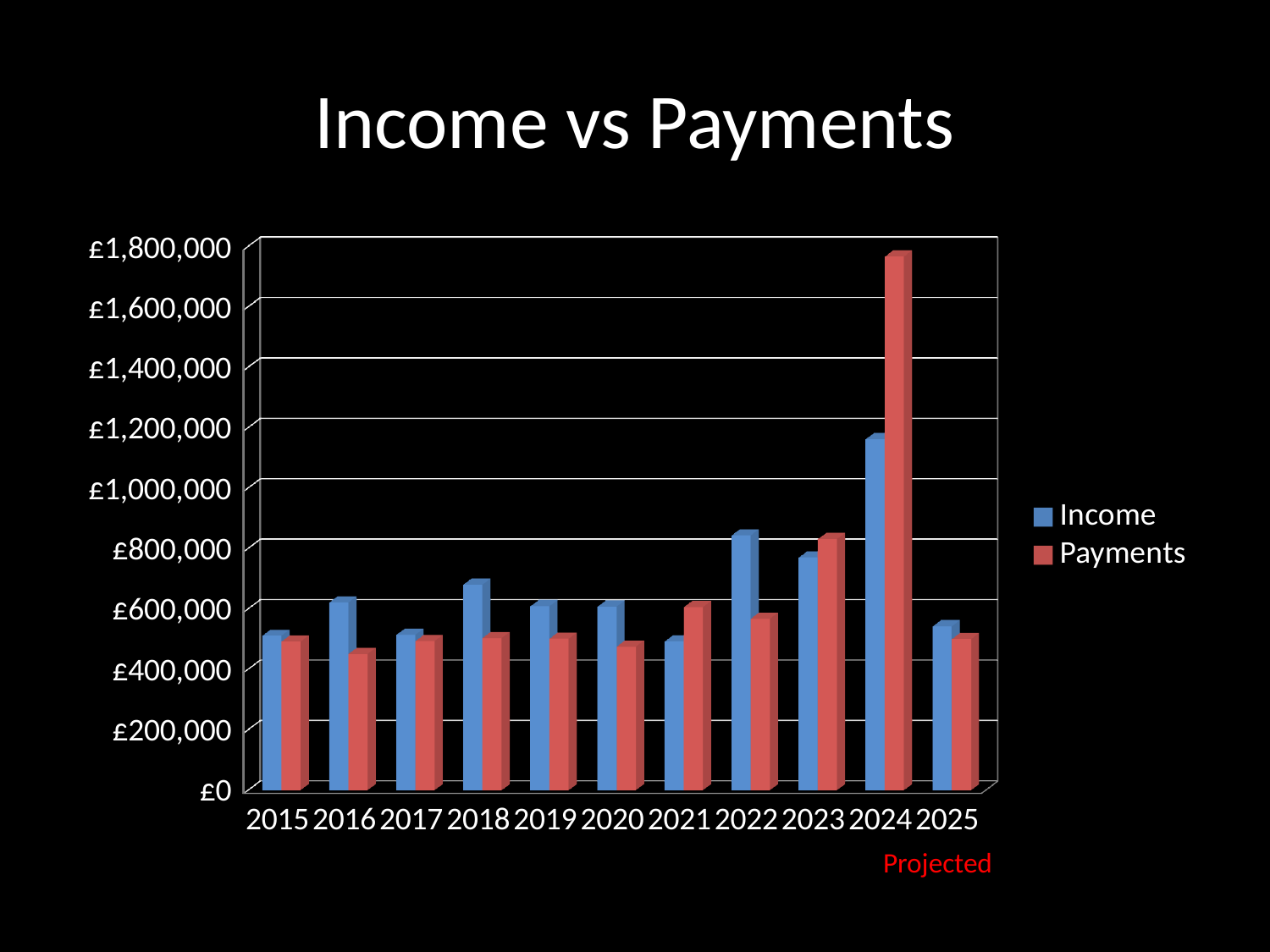
Is the value for Payments in 2024 greater or less than £1,600,000? greater How many years are shown on the x axis? 11 In 2022, which is larger, Income or Payments? Income In which year is Income highest? 2024 In 2021, which is larger, Income or Payments? Payments Is the value for Income in 2024 greater or less than £1,000,000? greater How many series does the legend list? 2 In which year are Payments highest? 2024 In 2024, which is larger, Income or Payments? Payments What is the title of the chart? Income vs Payments What kind of chart is shown on the slide? bar chart In which year are Payments lowest? 2016